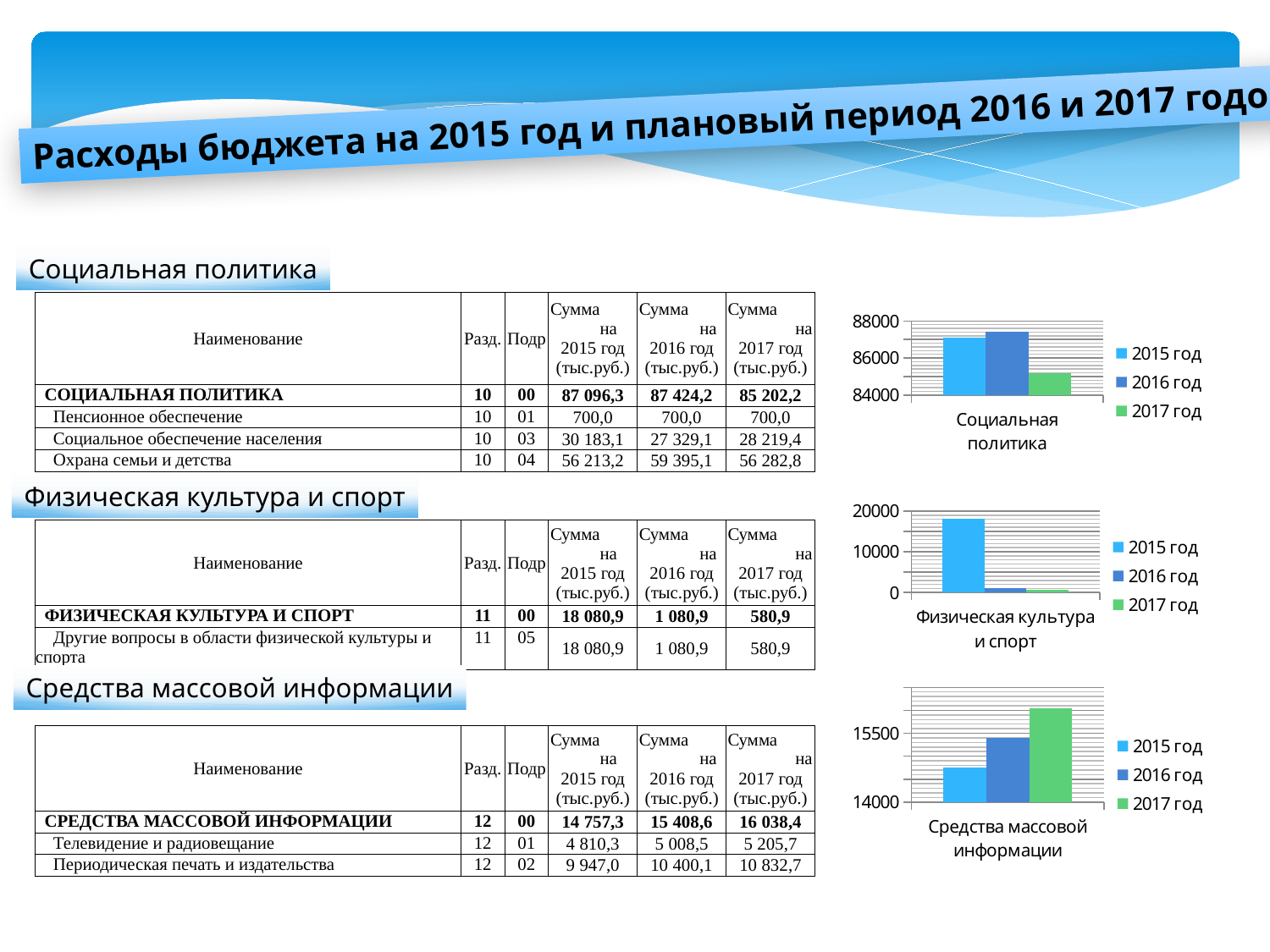
In the 'Социальная политика' chart, which year has the lowest value? 2017 год How many series does the legend of the 'Физическая культура и спорт' chart list? 3 In the 'Средства массовой информации' chart, which year has the highest value? 2017 год In the 'Социальная политика' chart, is the value for 2015 год greater or less than 86000? greater In the 'Физическая культура и спорт' chart, which year has the highest value? 2015 год How many bars are plotted in the 'Средства массовой информации' chart? 3 In the 'Физическая культура и спорт' chart, is the value for 2015 год greater or less than 10000? greater In the 'Социальная политика' chart, is the value for 2017 год greater or less than 86000? less In the 'Физическая культура и спорт' chart, do the values rise or fall from 2015 to 2017? fall What kind of chart is the 'Социальная политика' chart? bar chart In the 'Средства массовой информации' chart, do the values rise or fall from 2015 to 2017? rise